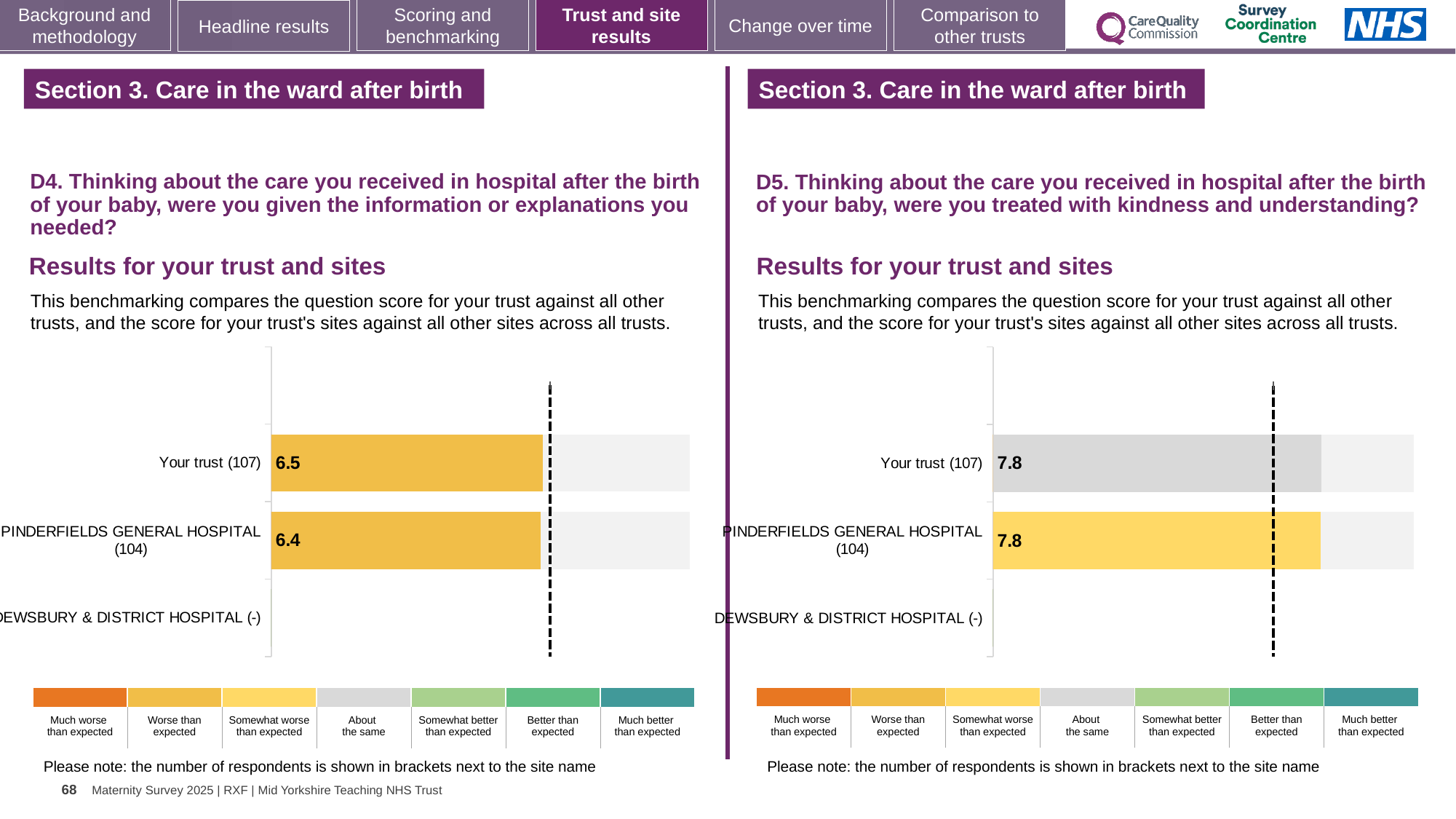
In the D5 chart on the right, which benchmark category does the colour of the Your trust bar correspond to in the legend? About the same In the D4 chart on the left, what is the difference between the score for Your trust and the score for PINDERFIELDS GENERAL HOSPITAL? 0.1 How many respondents are shown in brackets for Your trust in the D4 chart on the left? 107 What type of chart is used in the D5 chart on the right? Bar chart How many categories are listed on the vertical axis of the D4 chart on the left? 3 In the D5 chart on the right, which category has no bar plotted? DEWSBURY & DISTRICT HOSPITAL (-) In the D5 chart on the right, what is the score for PINDERFIELDS GENERAL HOSPITAL (104)? 7.8 In the D4 chart on the left, what is the score for PINDERFIELDS GENERAL HOSPITAL (104)? 6.4 In the D4 chart on the left, what is the score for Your trust (107)? 6.5 How many respondents are shown in brackets for PINDERFIELDS GENERAL HOSPITAL in the D5 chart on the right? 104 In the D4 chart on the left, which has the higher score, Your trust or PINDERFIELDS GENERAL HOSPITAL? Your trust In the D5 chart on the right, what is the score for Your trust (107)? 7.8